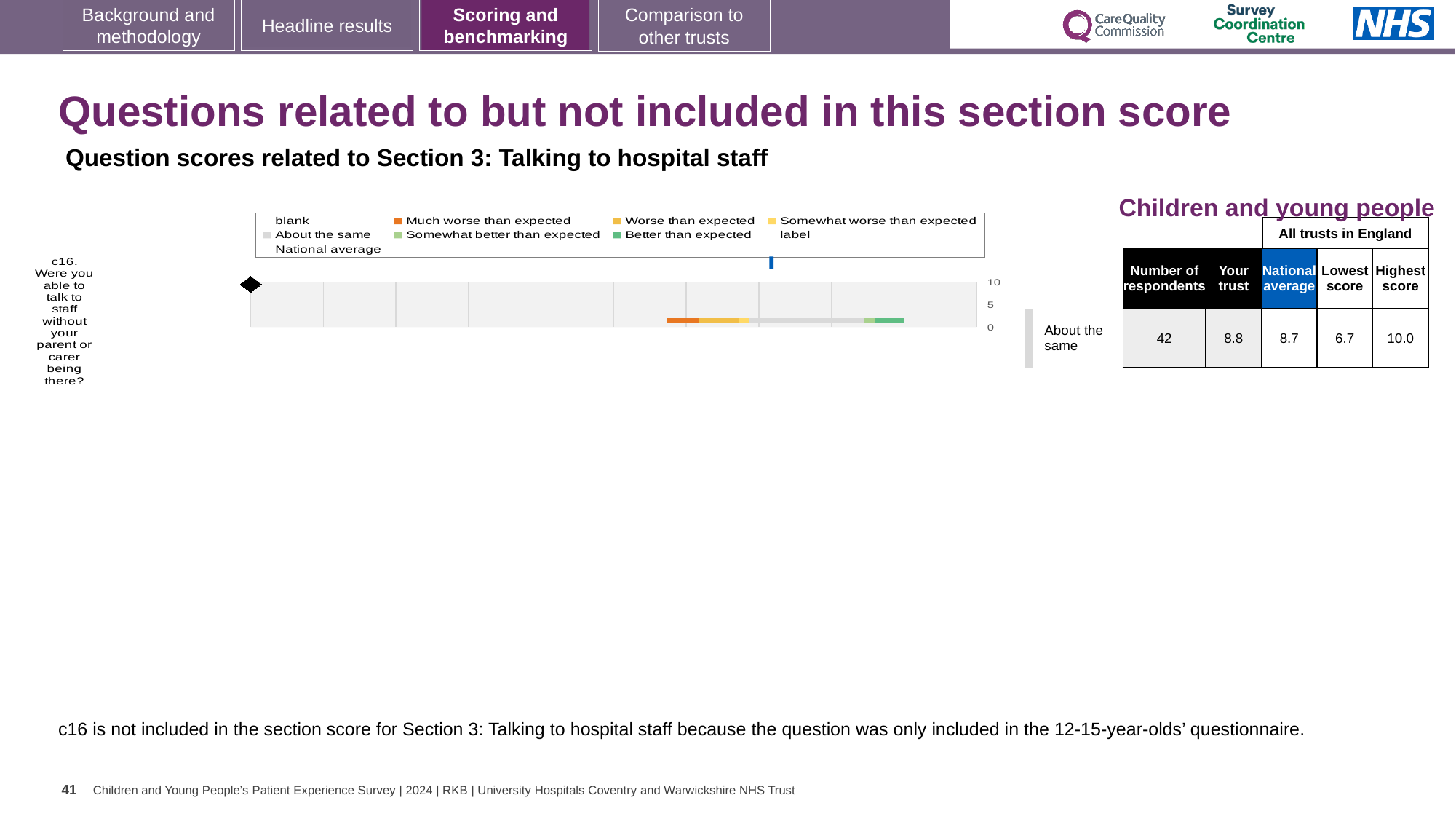
How many respondents answered c16? 42 What is the highest trust score for c16 across all trusts in England? 10.0 What kind of chart is used to show the c16 question score? bar chart How many survey questions are plotted in the chart? 1 What is the highest tick value shown on the chart's axis? 10 Which question is plotted in the chart? c16. Were you able to talk to staff without your parent or carer being there? What is the trust's score for c16 shown next to the chart? 8.8 Is the trust's c16 score higher or lower than the national average? higher What is the difference between the highest and lowest trust scores for c16? 3.3 Which benchmark category is the trust's c16 result placed in? About the same What is the national average score for c16 shown next to the chart? 8.7 What is the lowest trust score for c16 across all trusts in England? 6.7